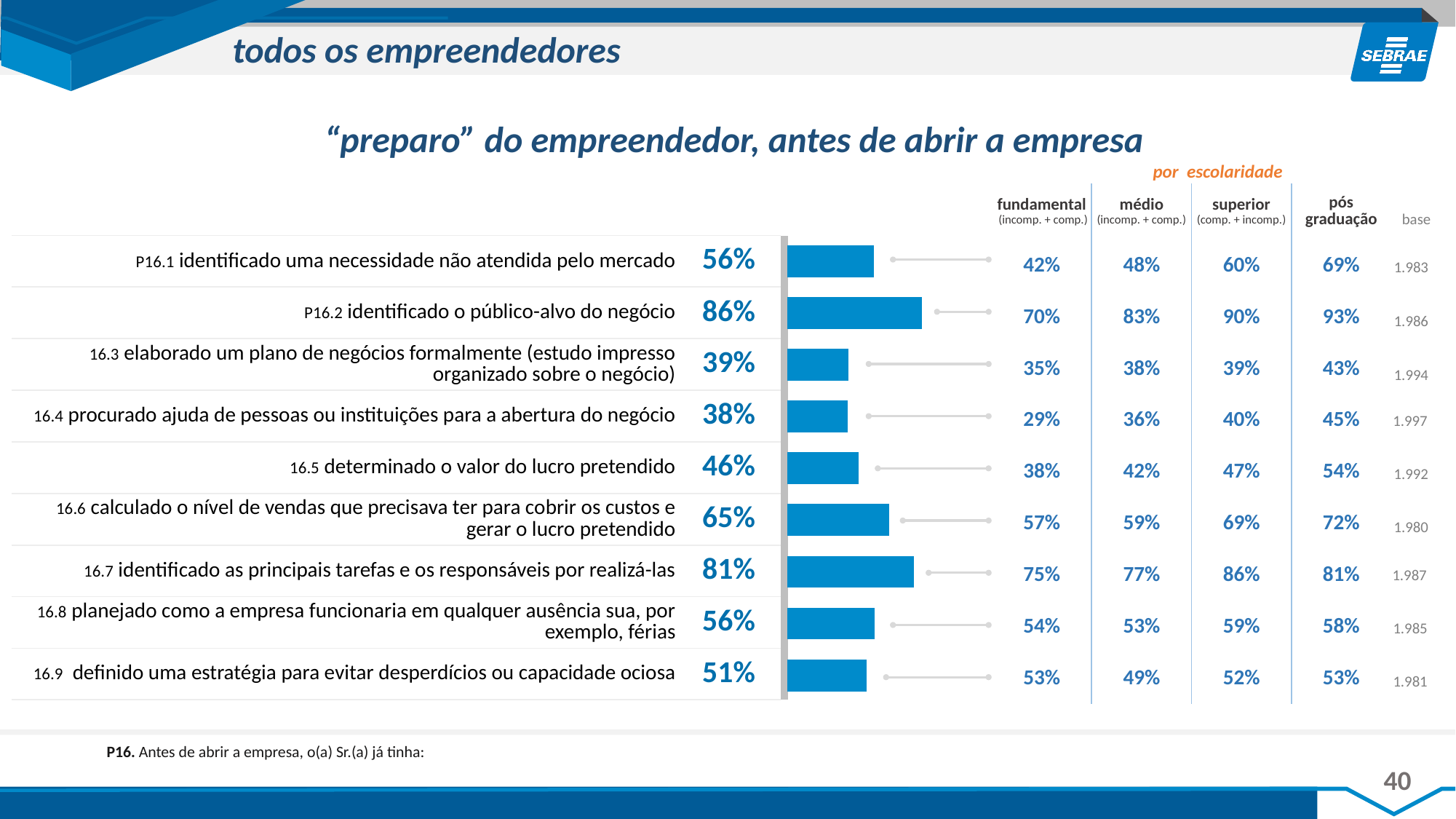
What percentage of entrepreneurs had identified the target audience of the business (P16.2) before opening the company? 86% Which item has the highest percentage in the bar chart? P16.2 identificado o público-alvo do negócio What is the title of the chart on this slide? "preparo" do empreendedor, antes de abrir a empresa What is the difference between the values for 16.3 (elaborado um plano de negócios) and 16.4 (procurado ajuda de pessoas ou instituições)? 1% What is the value shown for '16.3 elaborado um plano de negócios formalmente'? 39% Which is larger: the value for 16.6 (calculado o nível de vendas) or the value for 16.9 (definido uma estratégia para evitar desperdícios)? 16.6 calculado o nível de vendas What is the difference between the percentage for P16.2 (identificado o público-alvo do negócio) and 16.7 (identificado as principais tarefas e os responsáveis por realizá-las)? 5% What type of chart is used to display the percentages on this slide? Bar chart Which item has the lowest percentage in the bar chart? 16.4 procurado ajuda de pessoas ou instituições para a abertura do negócio What is the value shown for '16.5 determinado o valor do lucro pretendido'? 46% In the 'por escolaridade' table, what is the 'pós graduação' value for P16.2 identificado o público-alvo do negócio? 93% How many items (bars) are shown in the bar chart? 9